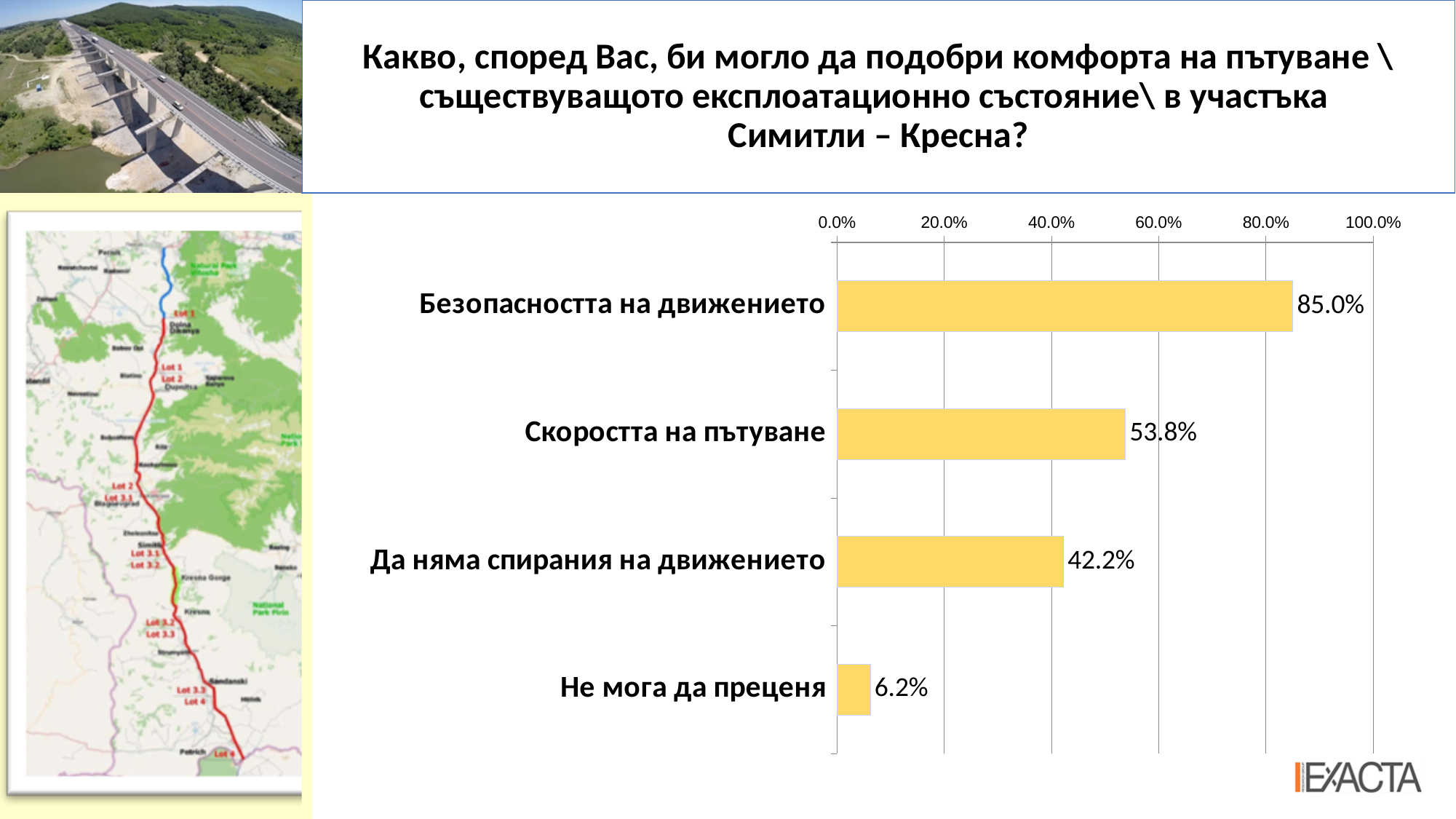
How many categories are shown in the chart? 4 What is the value for Скоростта на пътуване? 53.8% What is the value for Да няма спирания на движението? 42.2% Which category has the highest value? Безопасността на движението Is the value for Безопасността на движението greater or less than 80.0%? greater Which category has the lowest value? Не мога да преценя What is the difference between the values for Скоростта на пътуване and Да няма спирания на движението? 11.6% Which is larger, the value for Скоростта на пътуване or the value for Да няма спирания на движението? Скоростта на пътуване What is the difference between the values for Безопасността на движението and Скоростта на пътуване? 31.2% What is the value for Не мога да преценя? 6.2% What is the value for Безопасността на движението? 85.0% What kind of chart is shown on the slide? bar chart